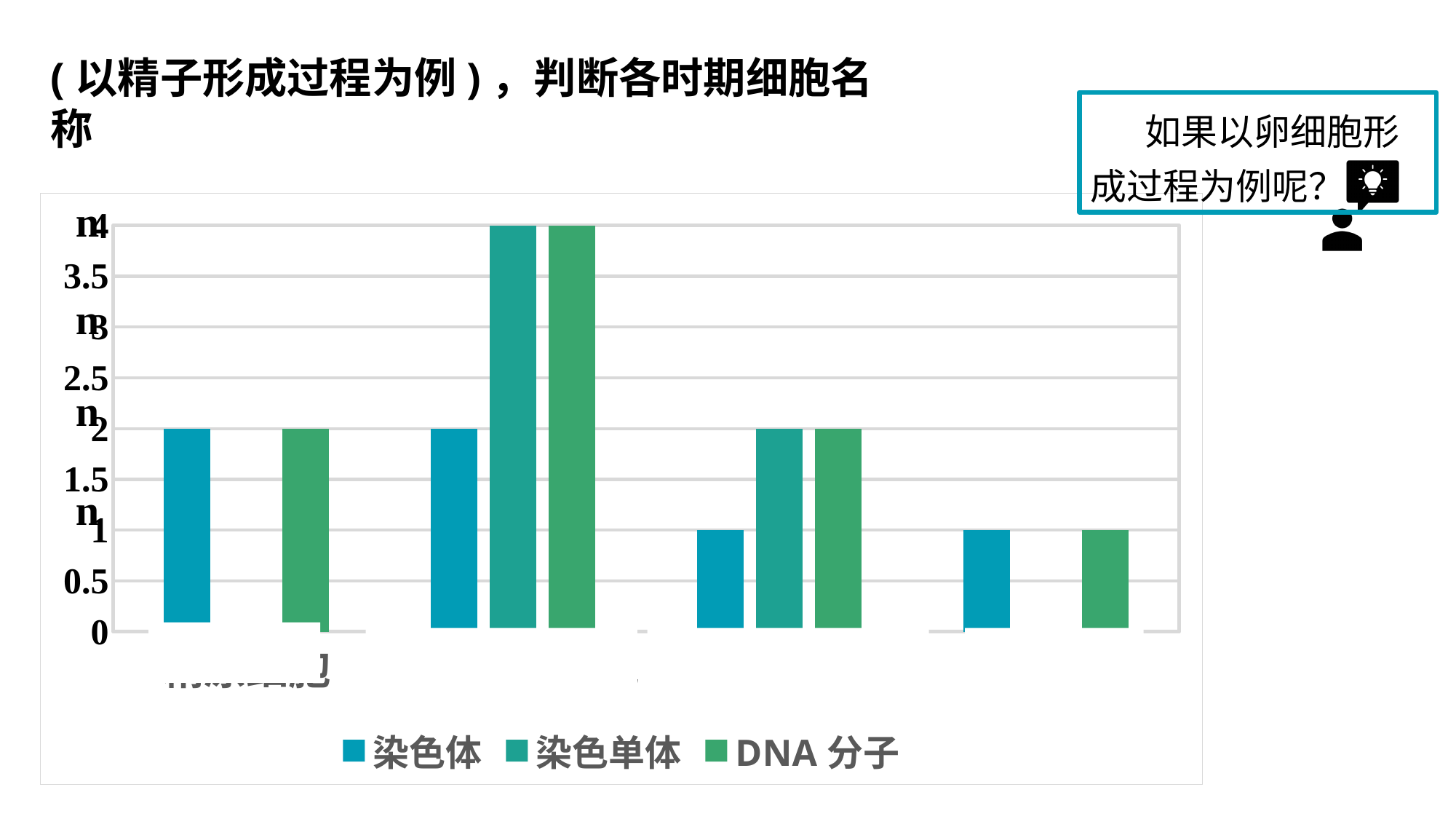
In the second group of bars from the left, what is the value for 染色单体? 4 Which group of bars has the highest value for DNA 分子? the second group from the left How many series does the chart legend list? 3 In the fourth group of bars from the left, what is the value for 染色体? 1 Is the 染色单体 value in the second group of bars from the left greater or less than 3? greater What are the three series named in the legend? 染色体, 染色单体, DNA 分子 In the second group of bars from the left, what is the difference between the DNA 分子 value and the 染色体 value? 2 In the third group of bars from the left, which is larger, the 染色单体 value or the 染色体 value? 染色单体 How many category groups of bars are plotted along the x axis? 4 In the third group of bars from the left, what is the value for DNA 分子? 2 What kind of chart is shown on the slide? bar chart In the second group of bars from the left, what is the value for 染色体? 2